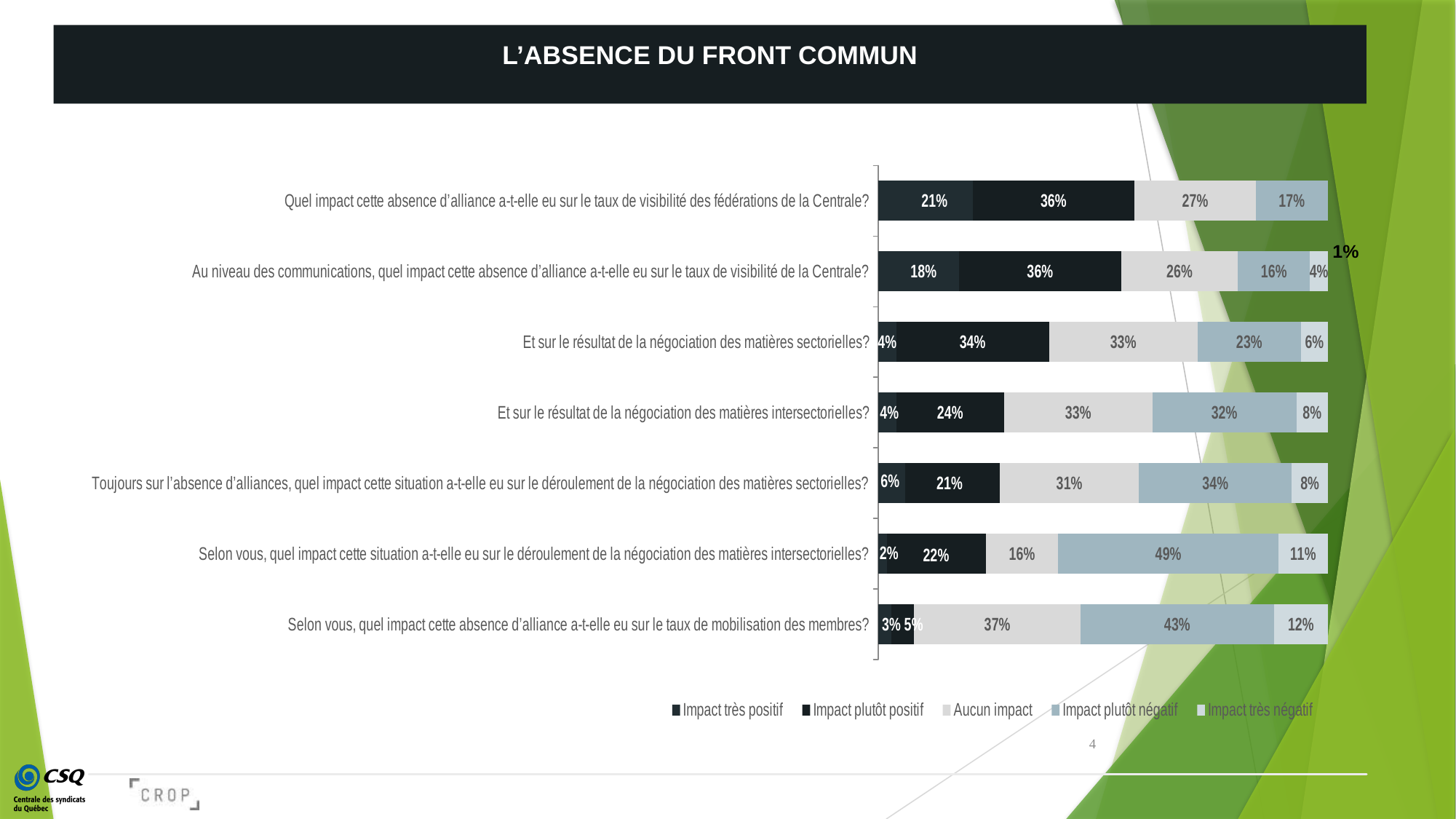
Which category has the lowest value for "Impact très positif"? Selon vous, quel impact cette situation a-t-elle eu sur le déroulement de la négociation des matières intersectorielles? Which is larger: "Impact plutôt négatif" for the question on the déroulement de la négociation des matières intersectorielles, or "Impact plutôt négatif" for the question on the taux de mobilisation des membres? Déroulement de la négociation des matières intersectorielles (49%) How many series does the legend list? 5 What is the value of "Impact plutôt négatif" for "Selon vous, quel impact cette situation a-t-elle eu sur le déroulement de la négociation des matières intersectorielles?" 49% What is the value of "Impact très négatif" for "Et sur le résultat de la négociation des matières sectorielles?" 6% How many question categories are plotted in the chart? 7 For "Quel impact cette absence d'alliance a-t-elle eu sur le taux de visibilité des fédérations de la Centrale?", what is the difference between "Impact plutôt positif" and "Aucun impact"? 9 percentage points What is the total of the stacked bar for "Et sur le résultat de la négociation des matières sectorielles?" 100% What is the value of "Impact très positif" for "Quel impact cette absence d'alliance a-t-elle eu sur le taux de visibilité des fédérations de la Centrale?" 21% Which category has the highest value for "Impact plutôt négatif"? Selon vous, quel impact cette situation a-t-elle eu sur le déroulement de la négociation des matières intersectorielles? What is the value of "Aucun impact" for "Selon vous, quel impact cette absence d'alliance a-t-elle eu sur le taux de mobilisation des membres?" 37% What kind of chart is shown on the slide? Stacked bar chart